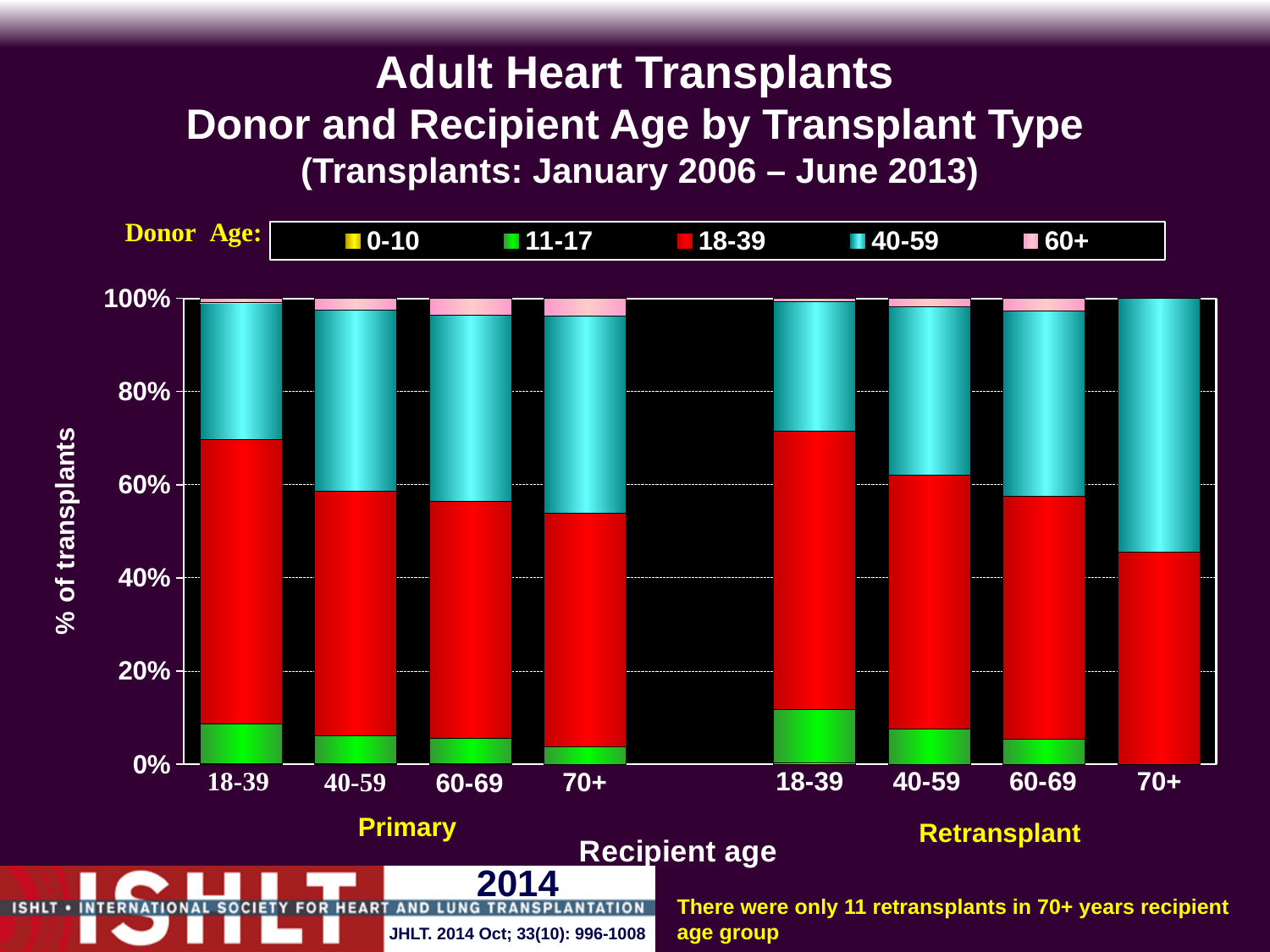
Is the share of donors aged 18-39 larger for Primary 18-39 recipients or for Retransplant 70+ recipients? Primary 18-39 Which donor age group is shown in red in the legend? 18-39 How many donor age groups does the legend list? 5 Which recipient age bar has the largest share of donors aged 40-59? Retransplant 70+ In the Primary 18-39 recipient bar, is the share of donors aged 11-17 greater or less than 20%? less In the Retransplant 70+ recipient bar, is the share of donors aged 18-39 greater or less than 40%? greater Which recipient age bar has the smallest share of donors aged 18-39? Retransplant 70+ What kind of chart is shown on the slide? Stacked bar chart Across the Primary recipient age groups from 18-39 to 70+, does the share of donors aged 40-59 rise or fall? rise How many recipient age categories are shown under Retransplant? 4 What is the label of the y axis? % of transplants How many recipient age bars are plotted in total across Primary and Retransplant? 8